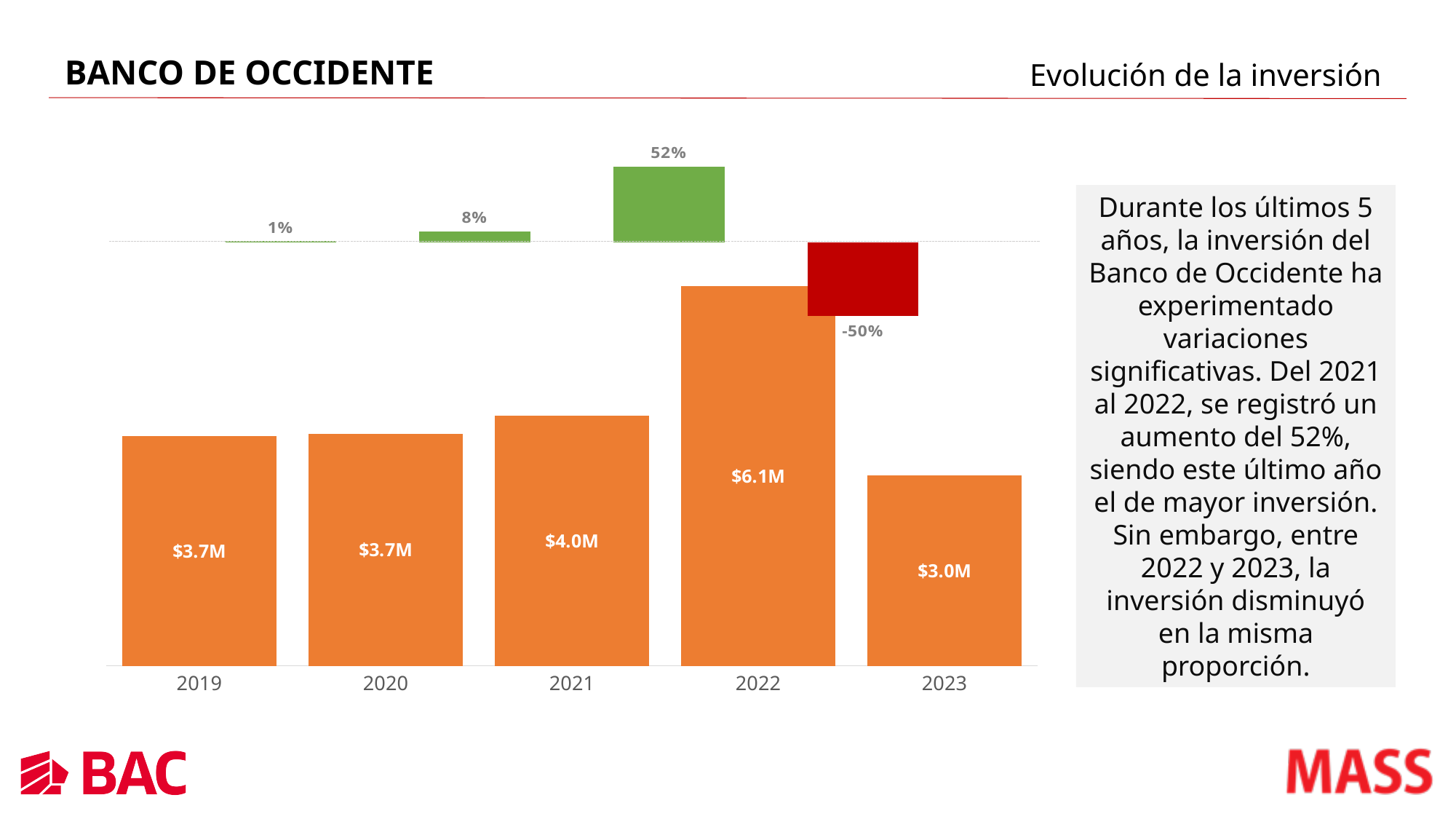
What percentage change is shown for 2021? 8% What type of chart is shown on the slide? Bar chart What colour is the bar showing the -50% change for 2023? Red What was the investment value for 2022? $6.1M What was the investment value for 2023? $3.0M What is the difference between the investment in 2022 and in 2021? $2.1M What percentage change is shown for 2022? 52% What percentage change is shown for 2023? -50% Which year had the lowest investment? 2023 Which year had a larger investment, 2021 or 2023? 2021 How many years are shown on the x axis? 5 Which year had the highest investment? 2022